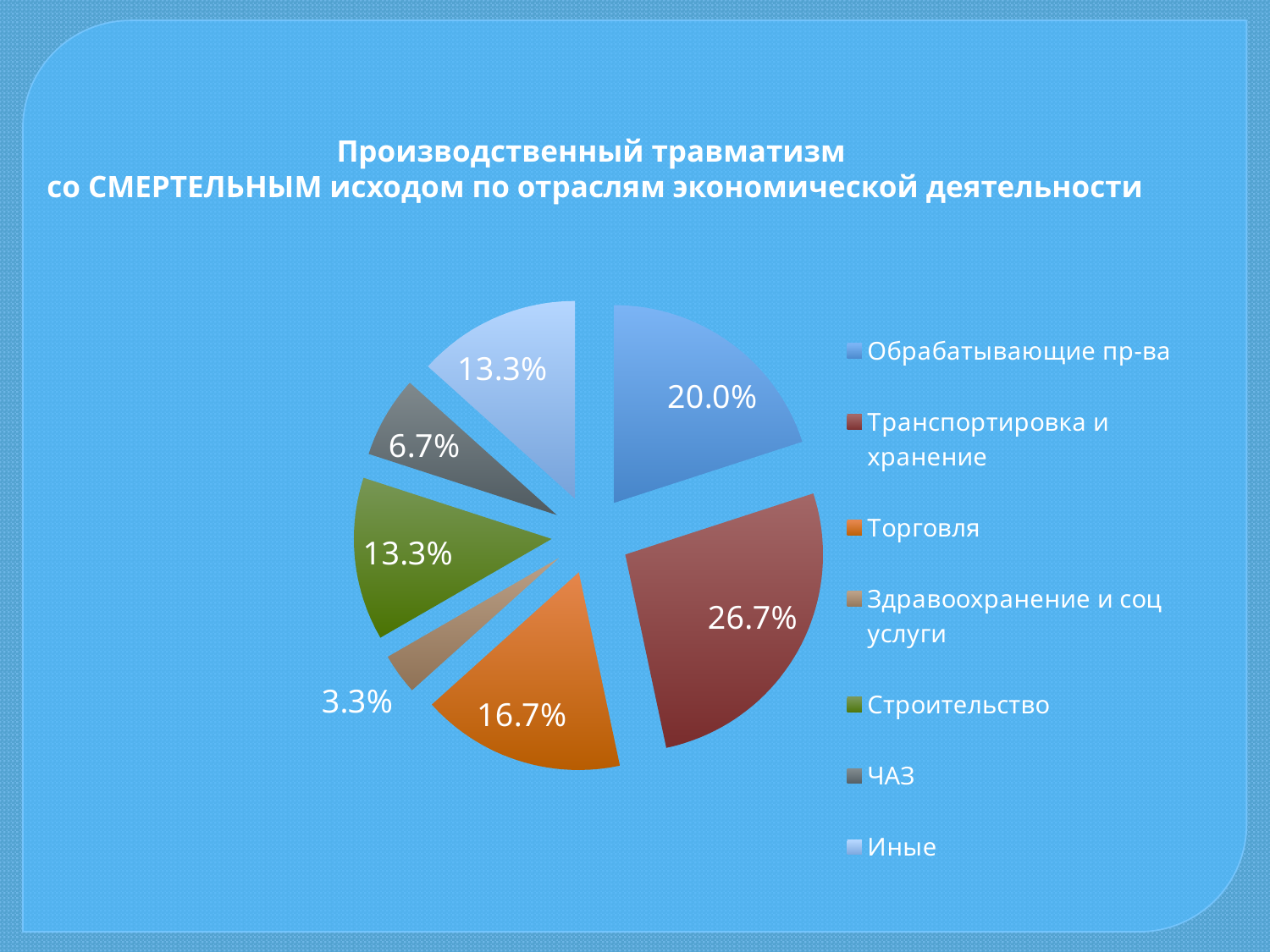
What share of the pie does Транспортировка и хранение have? 26.7% What is the difference between the shares of Транспортировка и хранение and Обрабатывающие пр-ва? 6.7% What is the value shown for ЧАЗ? 6.7% What kind of chart is shown on the slide? pie chart Which category has the largest share of the pie? Транспортировка и хранение How many categories does the legend list? 7 What is the value shown for Здравоохранение и соц услуги? 3.3% What is the value shown for Обрабатывающие пр-ва? 20.0% What is the title of the chart? Производственный травматизм со СМЕРТЕЛЬНЫМ исходом по отраслям экономической деятельности What is the value shown for Торговля? 16.7% Which is larger, the share for Торговля or the share for Строительство? Торговля Which category has the smallest share of the pie? Здравоохранение и соц услуги